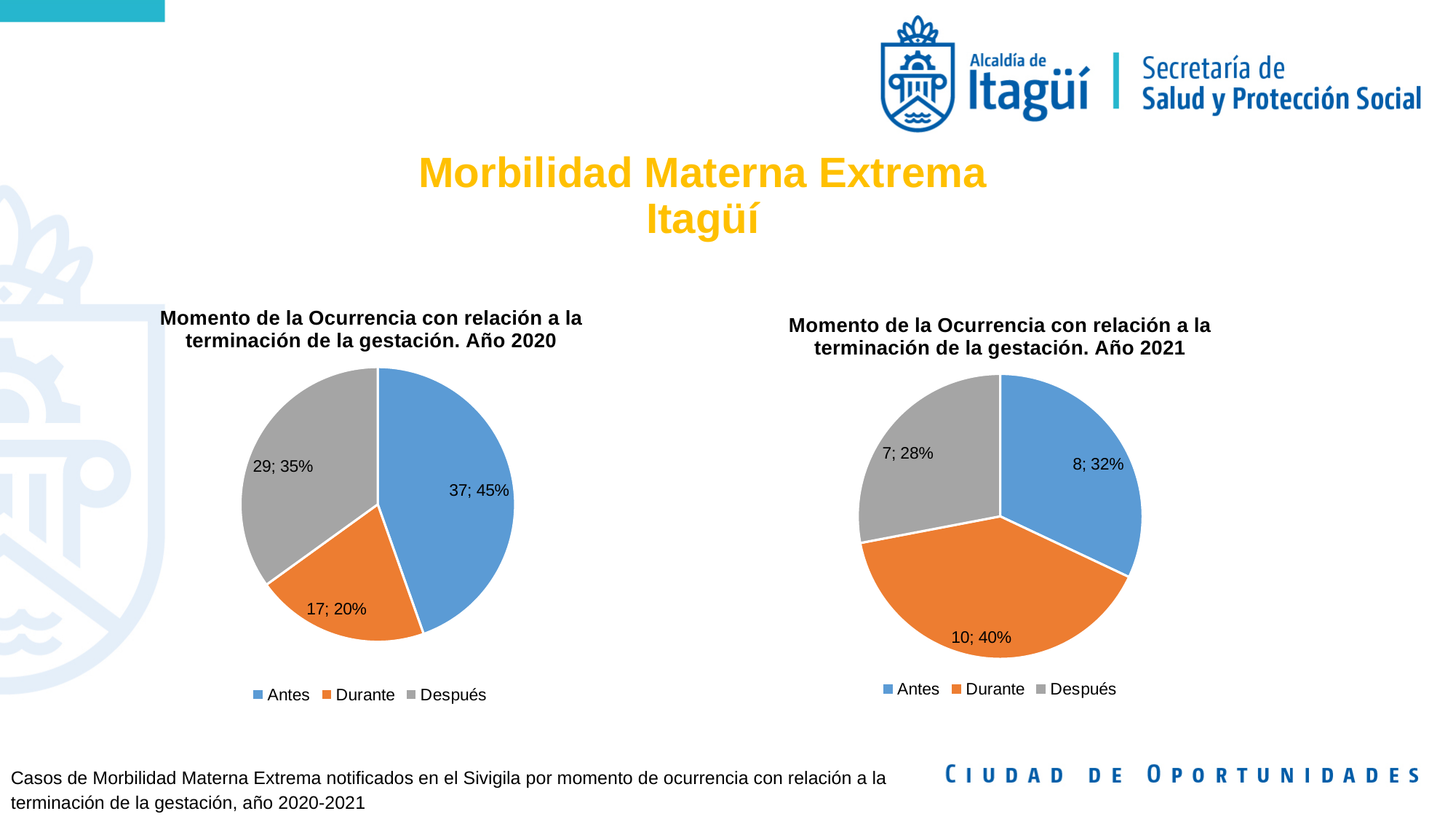
In the 'Año 2020' pie chart, what is the difference in cases between Antes and Durante? 20 In the 'Año 2020' pie chart, how many cases are labelled for Antes? 37 In the 'Año 2021' pie chart, how many cases are labelled for Durante? 10 In the 'Año 2021' pie chart, what percentage share does Después have? 28% In the 'Año 2020' pie chart, what percentage share does Después have? 35% In the 'Año 2021' pie chart, which is larger, Antes or Después? Antes In the 'Año 2020' pie chart, which category has the smallest slice? Durante In the 'Año 2020' pie chart, what is the total number of cases across all three slices? 83 In the 'Año 2021' pie chart, which category has the largest slice? Durante What type of chart is used for the 'Año 2021' data? Pie chart In the 'Año 2021' pie chart, what is the total number of cases across all three slices? 25 How many categories does the legend of the 'Año 2020' pie chart list? 3